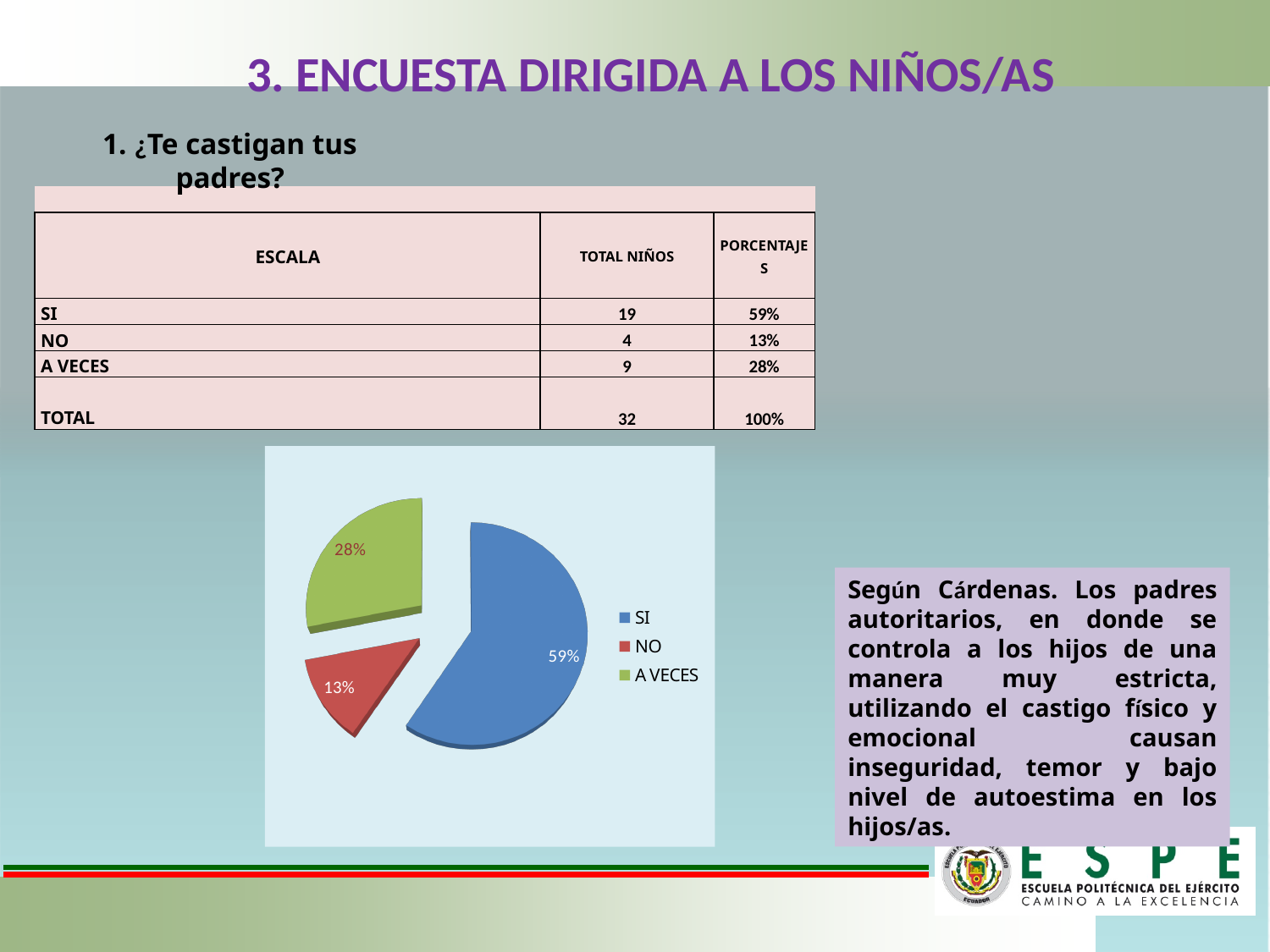
How many slices does the pie chart have? 3 What percentage does the A VECES slice of the pie chart show? 28% What percentage does the SI slice of the pie chart show? 59% What percentage does the NO slice of the pie chart show? 13% What kind of chart is shown on the slide? pie chart Which category has the largest slice in the pie chart? SI What is the difference in percentage points between the A VECES slice and the NO slice? 15 Which category has the smallest slice in the pie chart? NO What is the difference in percentage points between the SI slice and the A VECES slice? 31 How many entries does the legend of the pie chart list? 3 Which slice is larger in the pie chart, NO or A VECES? A VECES What colour is the SI slice in the pie chart? blue